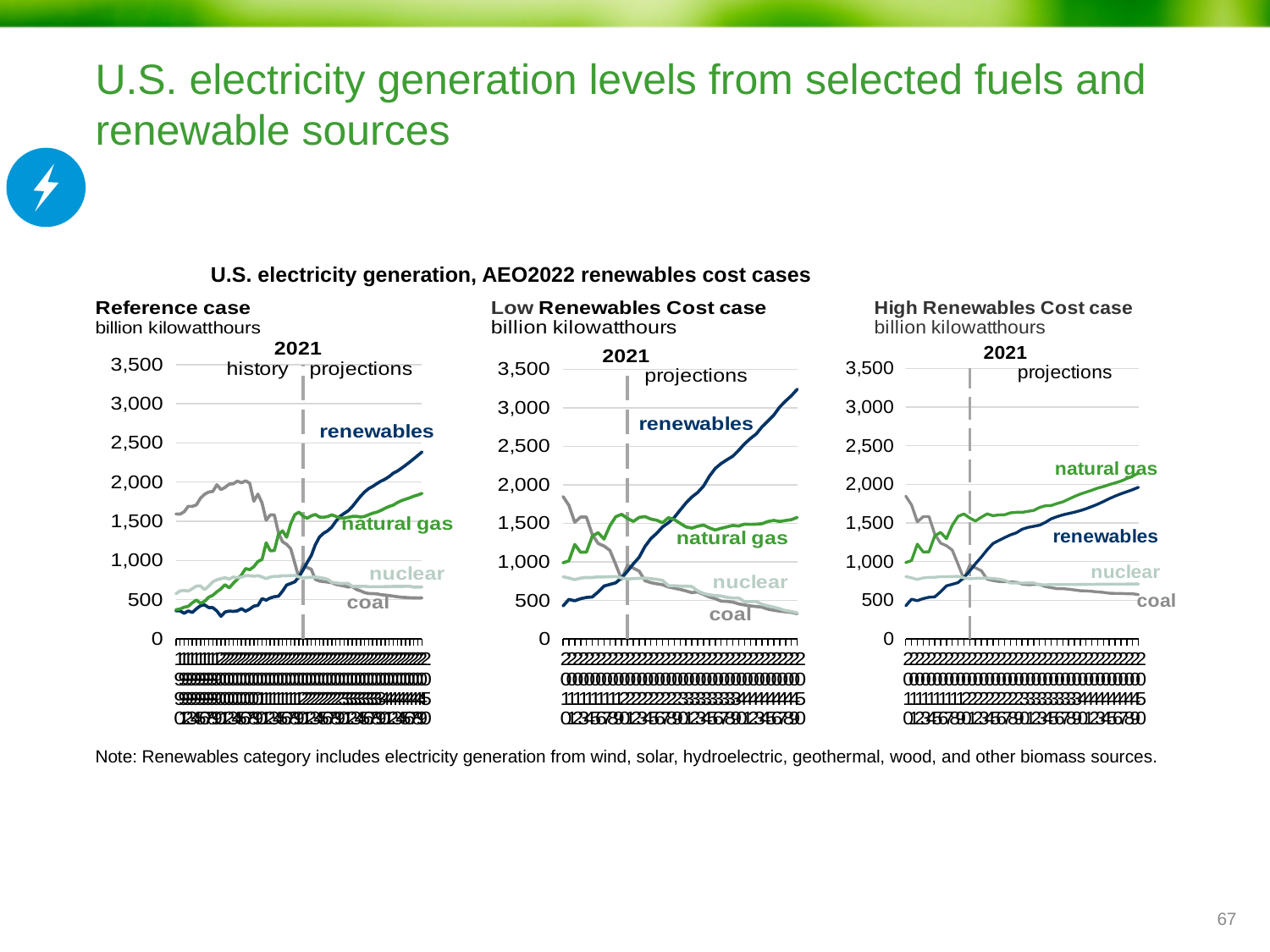
How many fuel series are plotted in the Low Renewables Cost case chart? 4 What unit is used on the y axis of the three charts? billion kilowatthours In the Reference case chart, which series is higher at the end of the projection period, renewables or natural gas? renewables In the Reference case chart, does the coal line rise or fall over the projection period? fall In the High Renewables Cost case chart, which series is higher at the end of the projection period, natural gas or renewables? natural gas What kind of chart is the Reference case chart? line chart What year does the dashed vertical line mark in each chart? 2021 In the Reference case chart, is the value for renewables at the end of the projection period greater or less than 2,000? greater In the Low Renewables Cost case chart, is the value for renewables at the end of the projection period greater or less than 3,000? greater In the Low Renewables Cost case chart, is the value for coal at the end of the projection period greater or less than 500? less In the Low Renewables Cost case chart, does the renewables line rise or fall over the projection period? rise